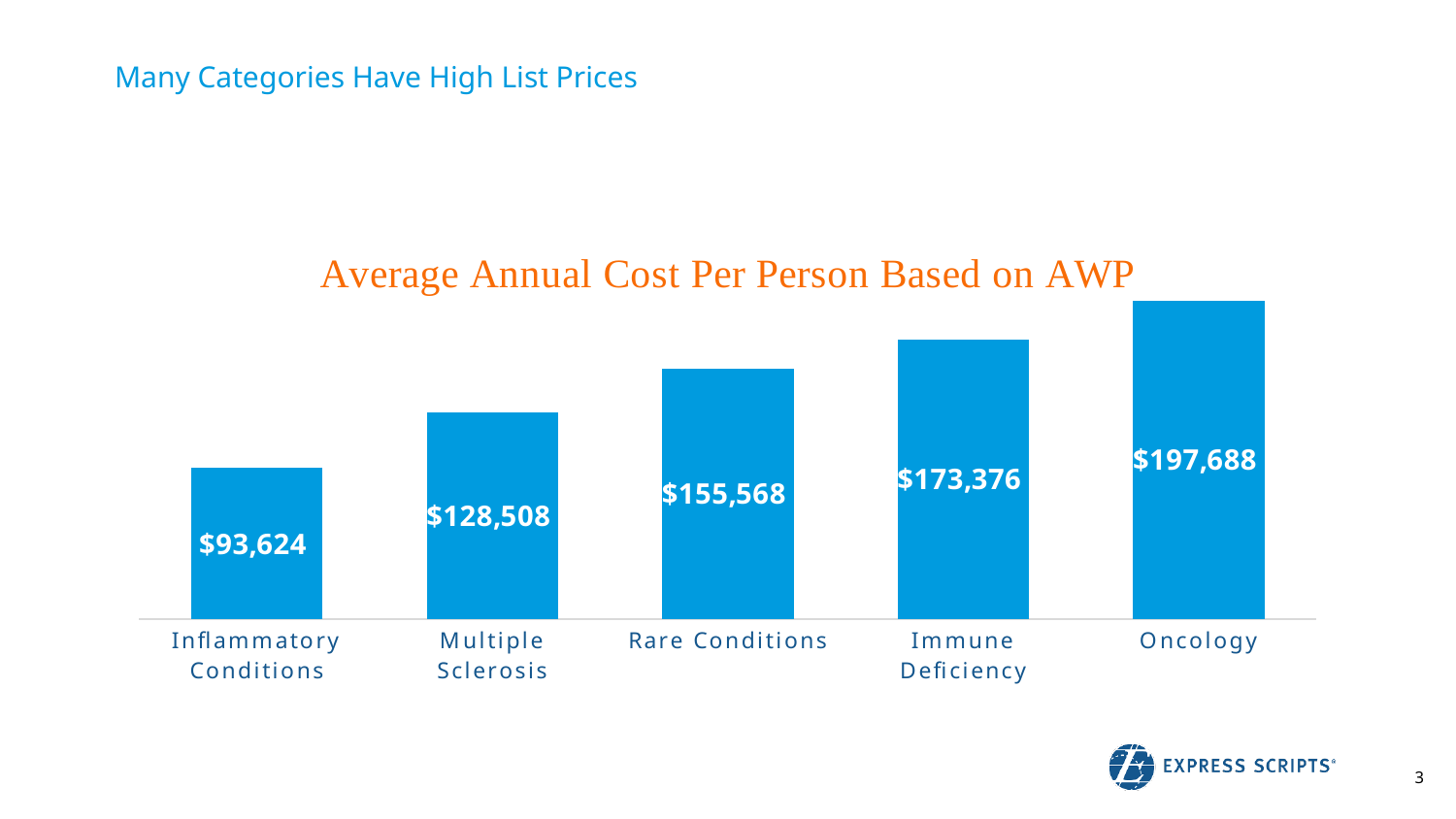
What type of chart is shown on the slide? Bar chart What is the difference between the average annual cost for Oncology and for Inflammatory Conditions? $104,064 Which has a higher average annual cost per person, Multiple Sclerosis or Rare Conditions? Rare Conditions What is the average annual cost per person for Multiple Sclerosis? $128,508 Which category has the lowest average annual cost per person? Inflammatory Conditions What is the difference between the average annual cost for Immune Deficiency and for Rare Conditions? $17,808 What is the average annual cost per person for Rare Conditions? $155,568 Which category has the highest average annual cost per person? Oncology What is the average annual cost per person for Immune Deficiency? $173,376 What is the average annual cost per person for Inflammatory Conditions? $93,624 How many categories are shown in the chart? 5 Do the values rise or fall moving from left to right across the categories? Rise